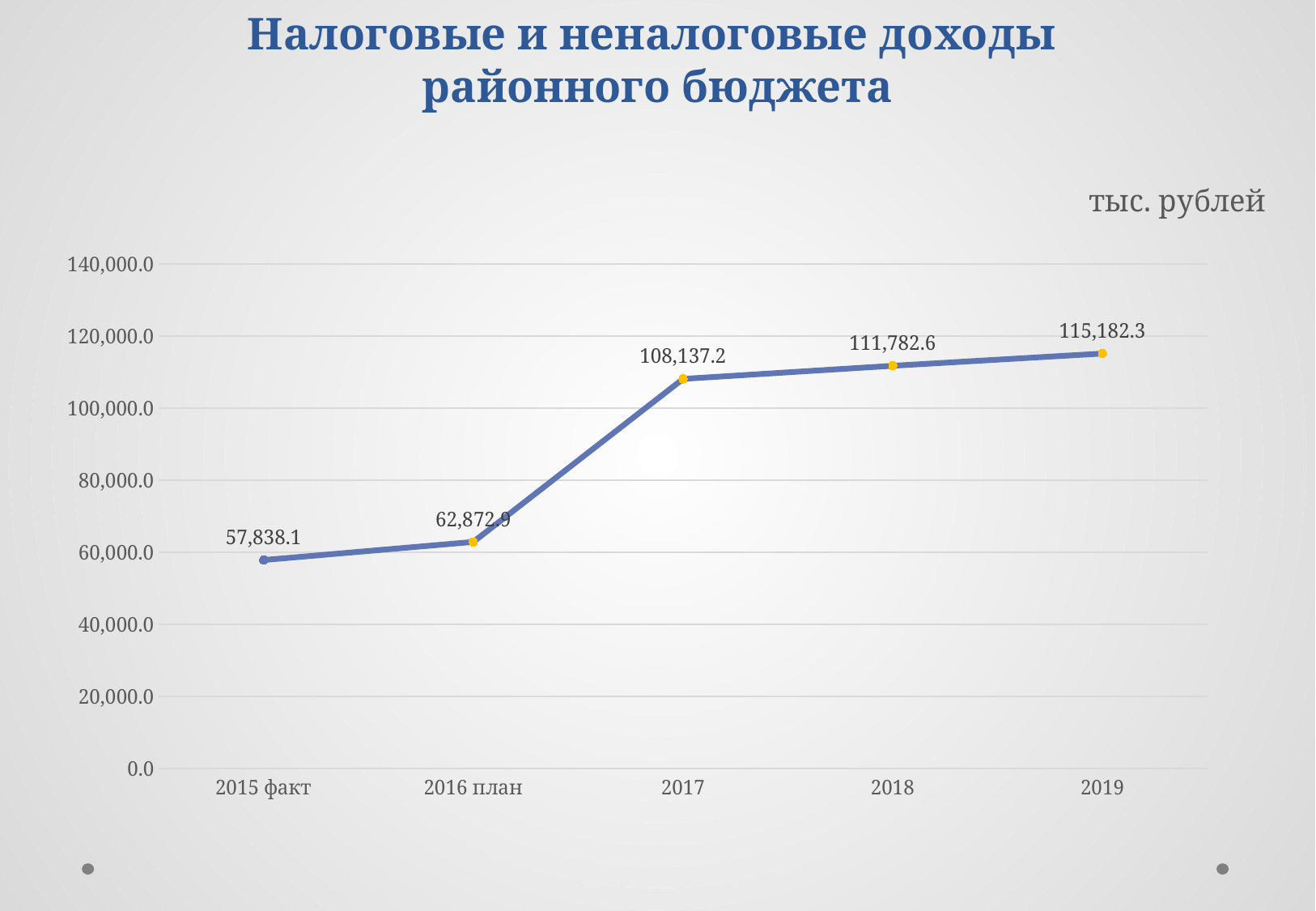
How many data points are plotted on the chart? 5 What is the value for 2019? 115,182.3 Which year has the highest value? 2019 What is the difference between the values for 2017 and 2016 план? 45,264.3 What kind of chart is shown on the slide? Line chart What is the difference between the values for 2019 and 2018? 3,399.7 What is the value for 2015 факт? 57,838.1 Which category has the lowest value? 2015 факт What is the value for 2016 план? 62,872.9 What is the value for 2017? 108,137.2 Do the values rise or fall from 2015 факт to 2019? Rise Which is larger, the value for 2018 or the value for 2016 план? 2018